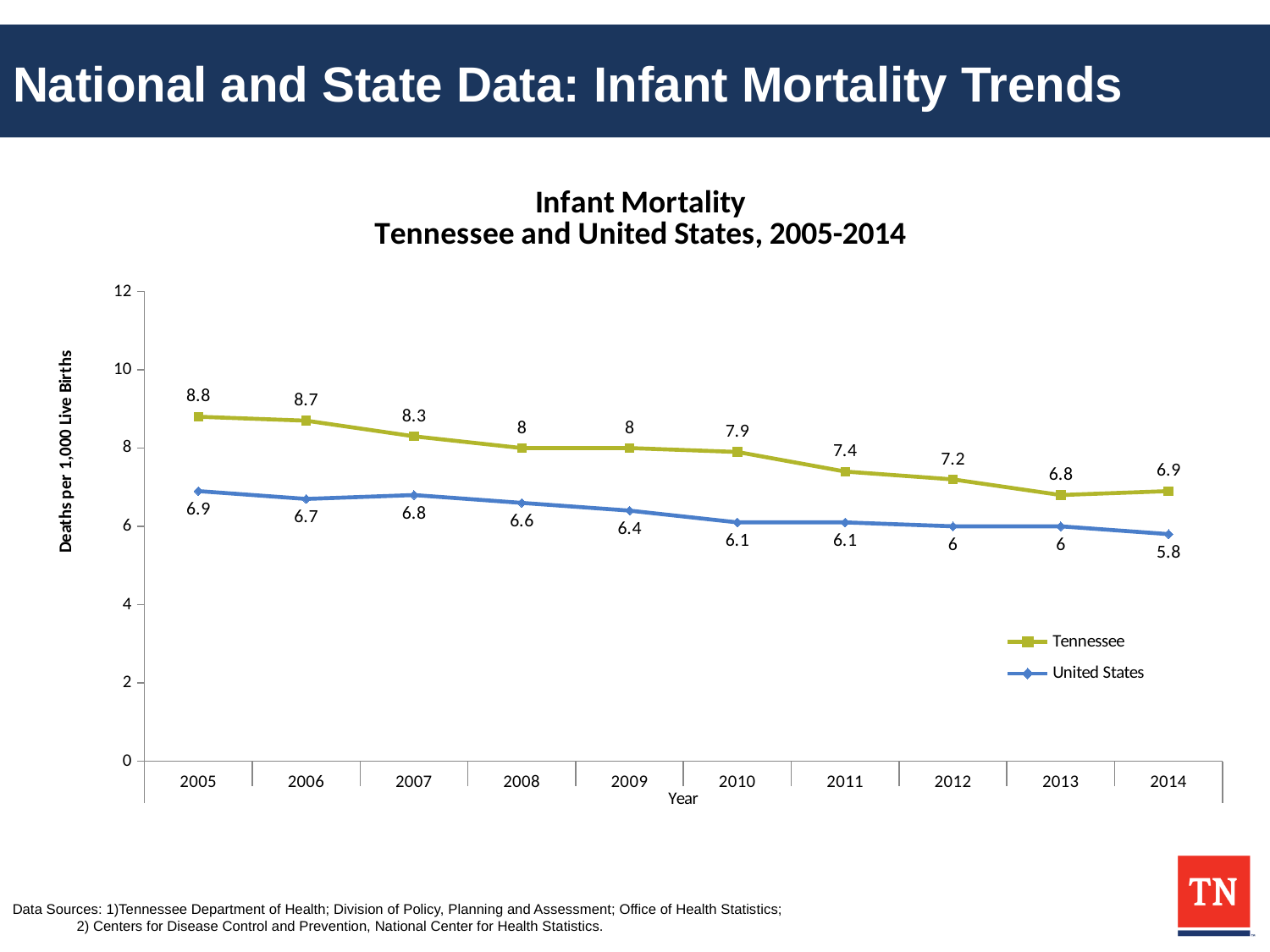
What is the Tennessee value for 2011? 7.4 What kind of chart is shown? Line chart How many series does the legend list? 2 Does the United States rate generally rise or fall from 2005 to 2014? Fall In which year is the United States rate lowest? 2014 How many years are shown on the x axis? 10 In which year is the Tennessee rate highest? 2005 What is the United States infant mortality rate in 2014? 5.8 What is the Tennessee infant mortality rate in 2005? 8.8 Which is larger in 2014, the Tennessee rate or the United States rate? Tennessee What is the label on the y axis? Deaths per 1,000 Live Births What is the difference between the Tennessee and United States rates in 2005? 1.9